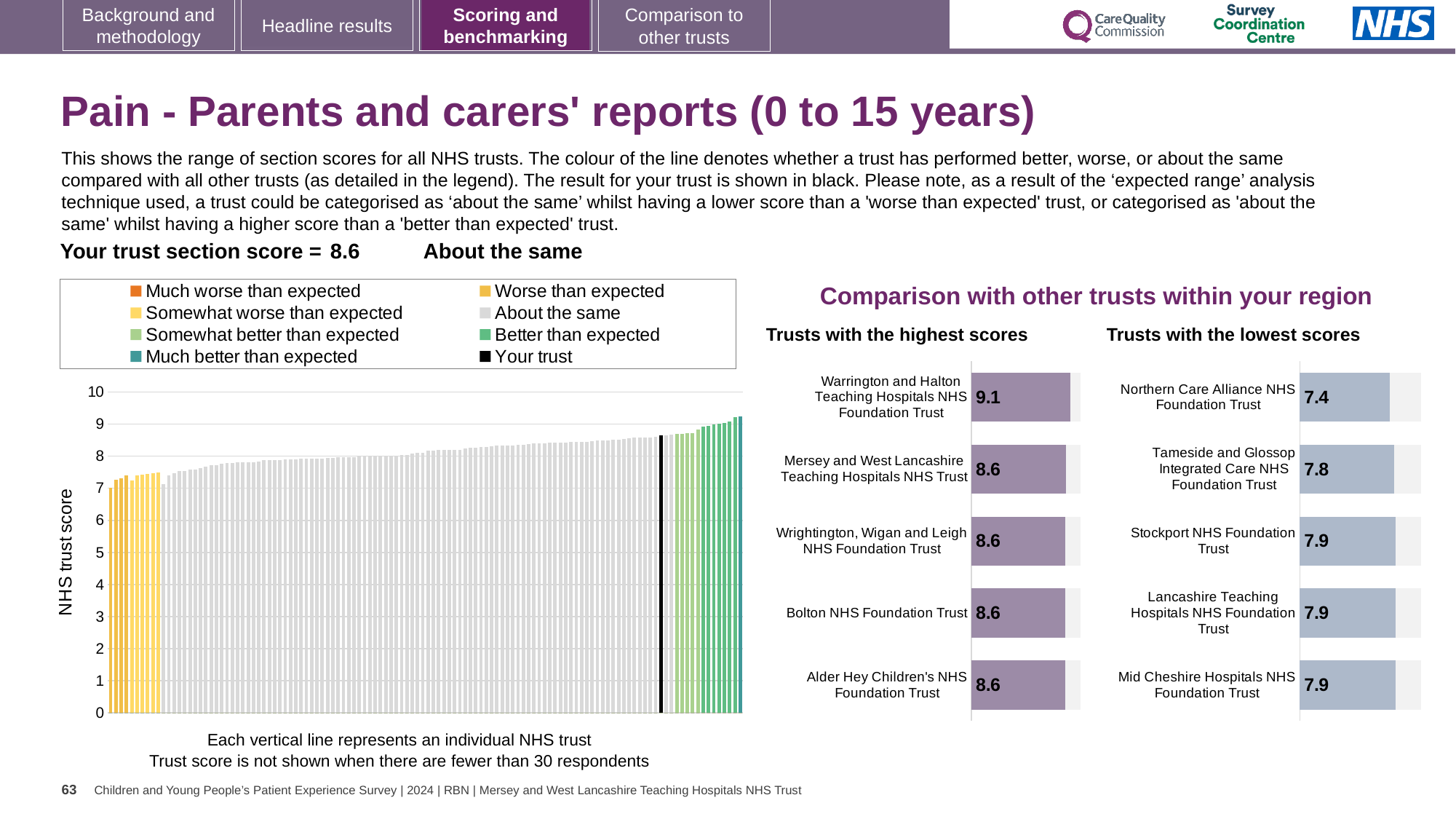
In the 'Trusts with the lowest scores' chart, what is the score for Northern Care Alliance NHS Foundation Trust? 7.4 In the 'Trusts with the highest scores' chart, which trust has the highest score? Warrington and Halton Teaching Hospitals NHS Foundation Trust How many entries does the legend above the large chart on the left list? 8 In the 'Trusts with the highest scores' chart, what is the difference between the scores of Warrington and Halton Teaching Hospitals NHS Foundation Trust and Bolton NHS Foundation Trust? 0.5 In the 'Trusts with the lowest scores' chart, which has the larger score: Tameside and Glossop Integrated Care NHS Foundation Trust or Stockport NHS Foundation Trust? Stockport NHS Foundation Trust In the large chart on the left, do the trust scores rise or fall from left to right along the x axis? rise In the 'Trusts with the lowest scores' chart, what is the score for Tameside and Glossop Integrated Care NHS Foundation Trust? 7.8 What kind of chart is the large chart on the left showing NHS trust scores? bar chart In the 'Trusts with the highest scores' chart, what is the score for Warrington and Halton Teaching Hospitals NHS Foundation Trust? 9.1 In the 'Trusts with the lowest scores' chart, which trust has the lowest score? Northern Care Alliance NHS Foundation Trust In the 'Trusts with the lowest scores' chart, how many trusts are listed? 5 In the large chart on the left, is the value for the black 'Your trust' bar greater or less than 8? greater